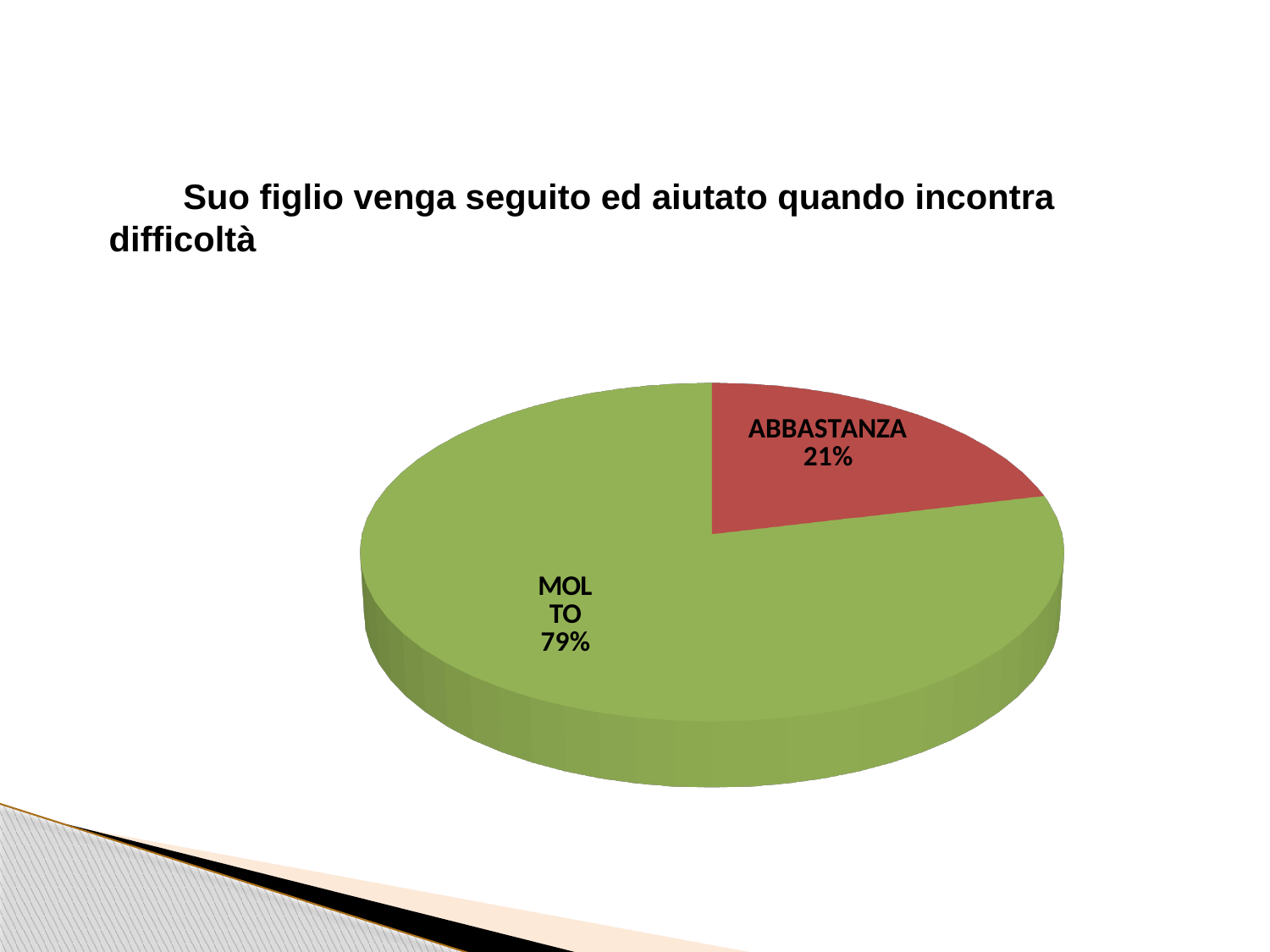
Which slice is larger, MOLTO or ABBASTANZA? MOLTO Is the share for ABBASTANZA greater or less than 50%? less What kind of chart is shown on the slide? Pie chart What is the total of the two slices shown in the pie chart? 100% What colour is the MOLTO slice? Green What colour is the ABBASTANZA slice? Red What share of the pie does the ABBASTANZA slice represent? 21% Which category has the largest slice of the pie? MOLTO What share of the pie does the MOLTO slice represent? 79% Which category has the smallest slice of the pie? ABBASTANZA How many slices does the pie chart have? 2 What is the difference in percentage points between the MOLTO and ABBASTANZA slices? 58